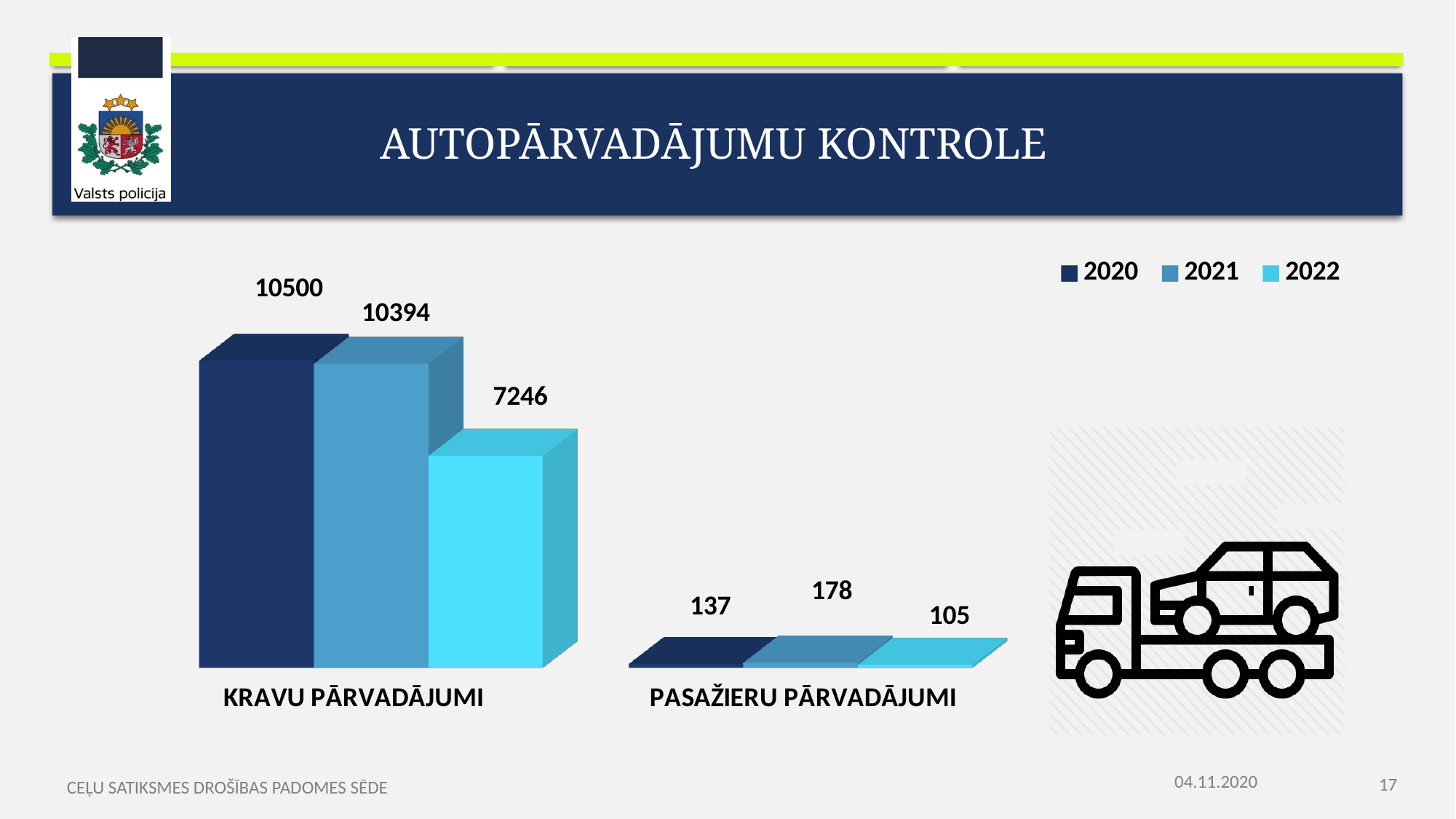
How many categories are shown on the x axis? 2 What is the value for PASAŽIERU PĀRVADĀJUMI in 2021? 178 Which year has the lowest value for KRAVU PĀRVADĀJUMI? 2022 What kind of chart is shown on the slide? bar chart Which is larger for PASAŽIERU PĀRVADĀJUMI: the 2020 value or the 2022 value? 2020 What is the value for PASAŽIERU PĀRVADĀJUMI in 2022? 105 What is the value for KRAVU PĀRVADĀJUMI in 2022? 7246 What is the value for KRAVU PĀRVADĀJUMI in 2020? 10500 Which year has the highest value for PASAŽIERU PĀRVADĀJUMI? 2021 What is the difference between the 2020 and 2021 values for KRAVU PĀRVADĀJUMI? 106 What is the difference between the 2021 and 2022 values for PASAŽIERU PĀRVADĀJUMI? 73 How many series does the legend list? 3